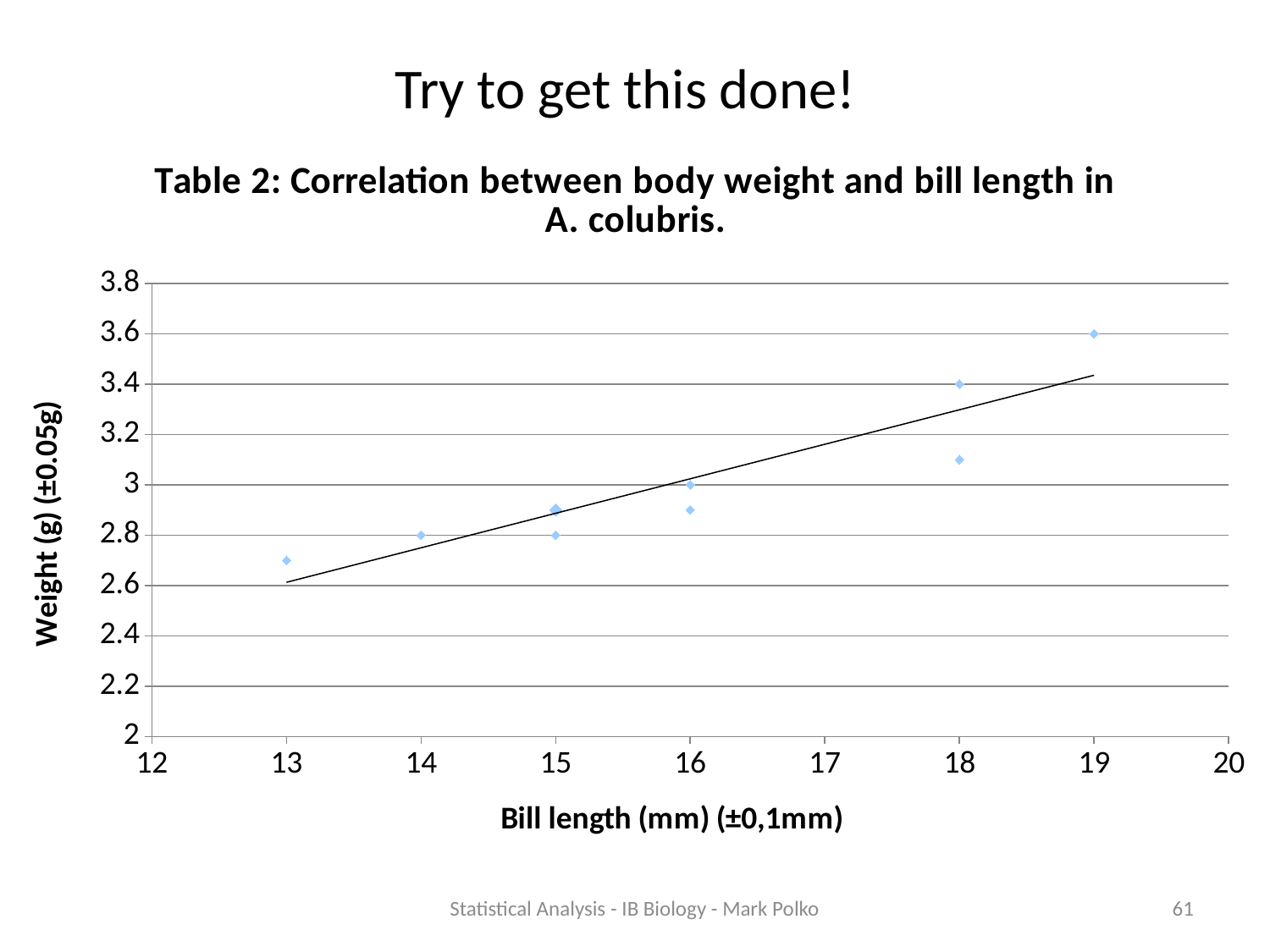
What is the higher of the two weights plotted at a bill length of 18 mm? 3.4 Is the weight plotted at a bill length of 13 mm greater or less than 2.8? less What is the title of the chart? Table 2: Correlation between body weight and bill length in A. colubris. What is the difference between the weight plotted at 19 mm and the weight plotted at 14 mm? 0.8 What kind of chart is shown on the slide? scatter chart At which bill length is the highest weight plotted? 19 What is the label of the x axis? Bill length (mm) (±0,1mm) What is the weight plotted at a bill length of 14 mm? 2.8 At which bill length is the lowest weight plotted? 13 What is the weight plotted at a bill length of 19 mm? 3.6 Which has the larger plotted weight: the point at 19 mm or the point at 13 mm? 19 mm Do the weight values generally rise or fall as bill length increases along the x axis? rise